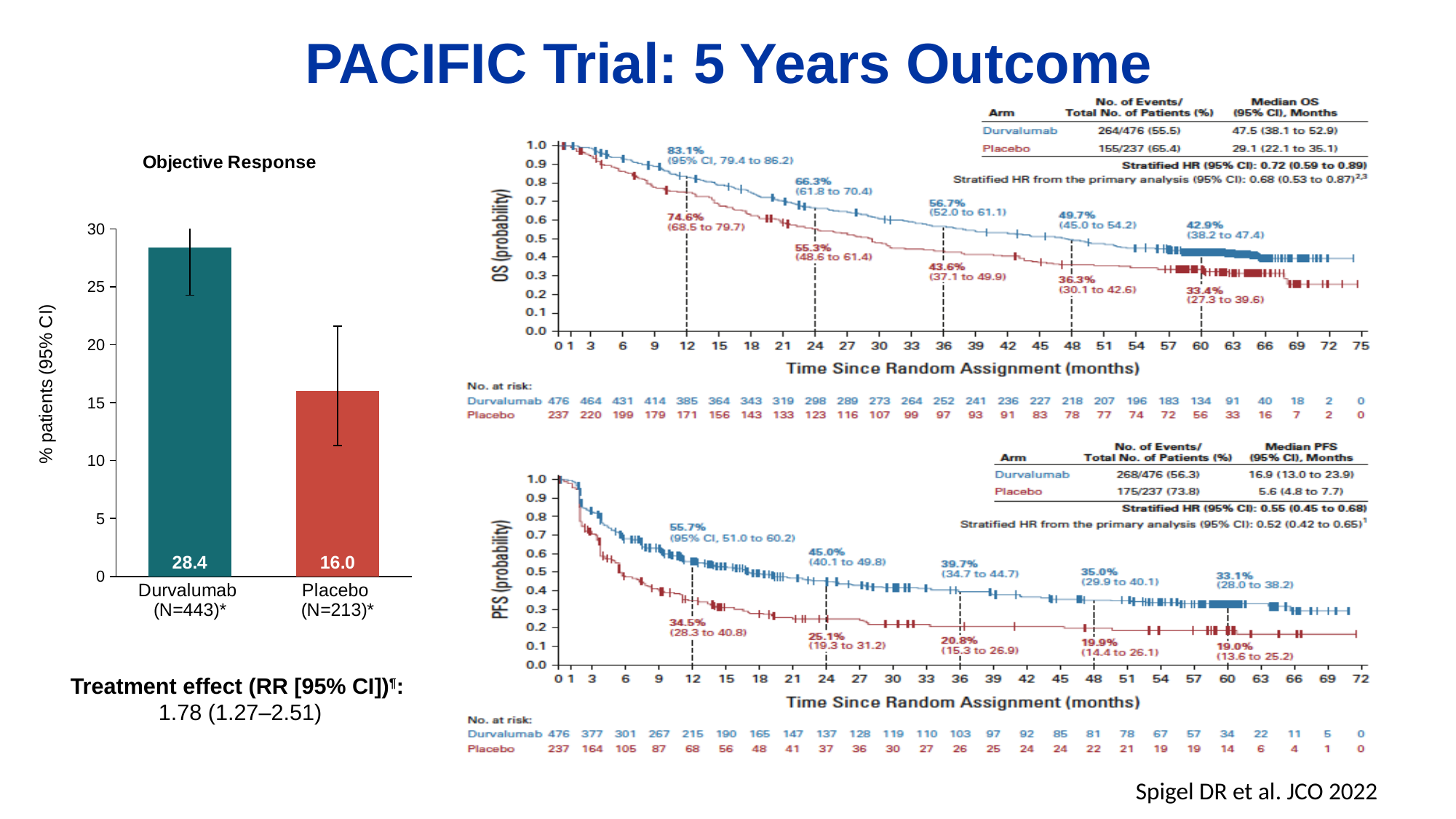
In the OS (probability) chart, do the survival curves rise or fall as time since random assignment increases? Fall In the PFS (probability) chart, what is the Durvalumab PFS rate at 24 months? 45.0% In the Objective Response bar chart, what is the value for Placebo? 16.0 In the OS (probability) chart, what is the median OS in months for Durvalumab? 47.5 In the Objective Response bar chart, which arm has the higher value? Durvalumab In the PFS (probability) chart, what is the median PFS in months for Placebo? 5.6 In the Objective Response bar chart, what is the value for Durvalumab? 28.4 In the OS (probability) chart, what is the Durvalumab OS rate at 60 months? 42.9% What kind of chart is the Objective Response chart? Bar chart In the Objective Response bar chart, what is the difference between the Durvalumab and Placebo values? 12.4 In the OS (probability) chart, what is the Placebo OS rate at 12 months? 74.6% How many categories are shown in the Objective Response bar chart? 2